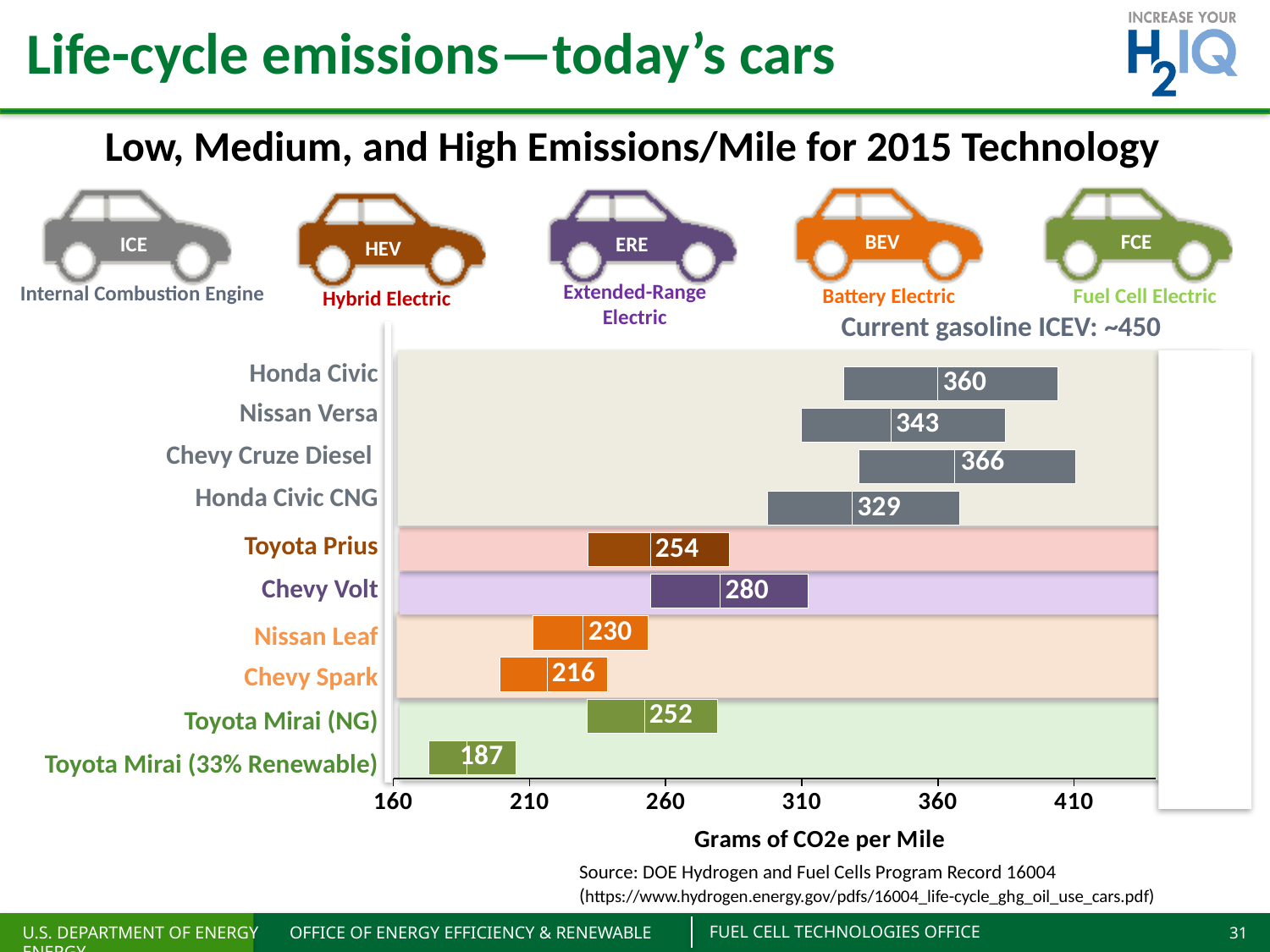
Which vehicle has the lowest labeled emissions value? Toyota Mirai (33% Renewable) How many vehicles are listed on the chart? 10 What is the labeled emissions value for the Toyota Mirai (33% Renewable)? 187 What is the labeled emissions value for the Chevy Volt? 280 What kind of chart is shown on the slide? bar chart Which vehicle has the highest labeled emissions value? Chevy Cruze Diesel What is the difference between the labeled values for the Chevy Cruze Diesel and the Toyota Mirai (33% Renewable)? 179 What is the difference between the labeled values for the Honda Civic and the Nissan Versa? 17 Which has a larger labeled value, the Nissan Leaf or the Chevy Spark? Nissan Leaf Is the labeled value for the Honda Civic CNG greater or less than 310? greater What is the title of the chart's x axis? Grams of CO2e per Mile What is the labeled emissions value for the Honda Civic? 360